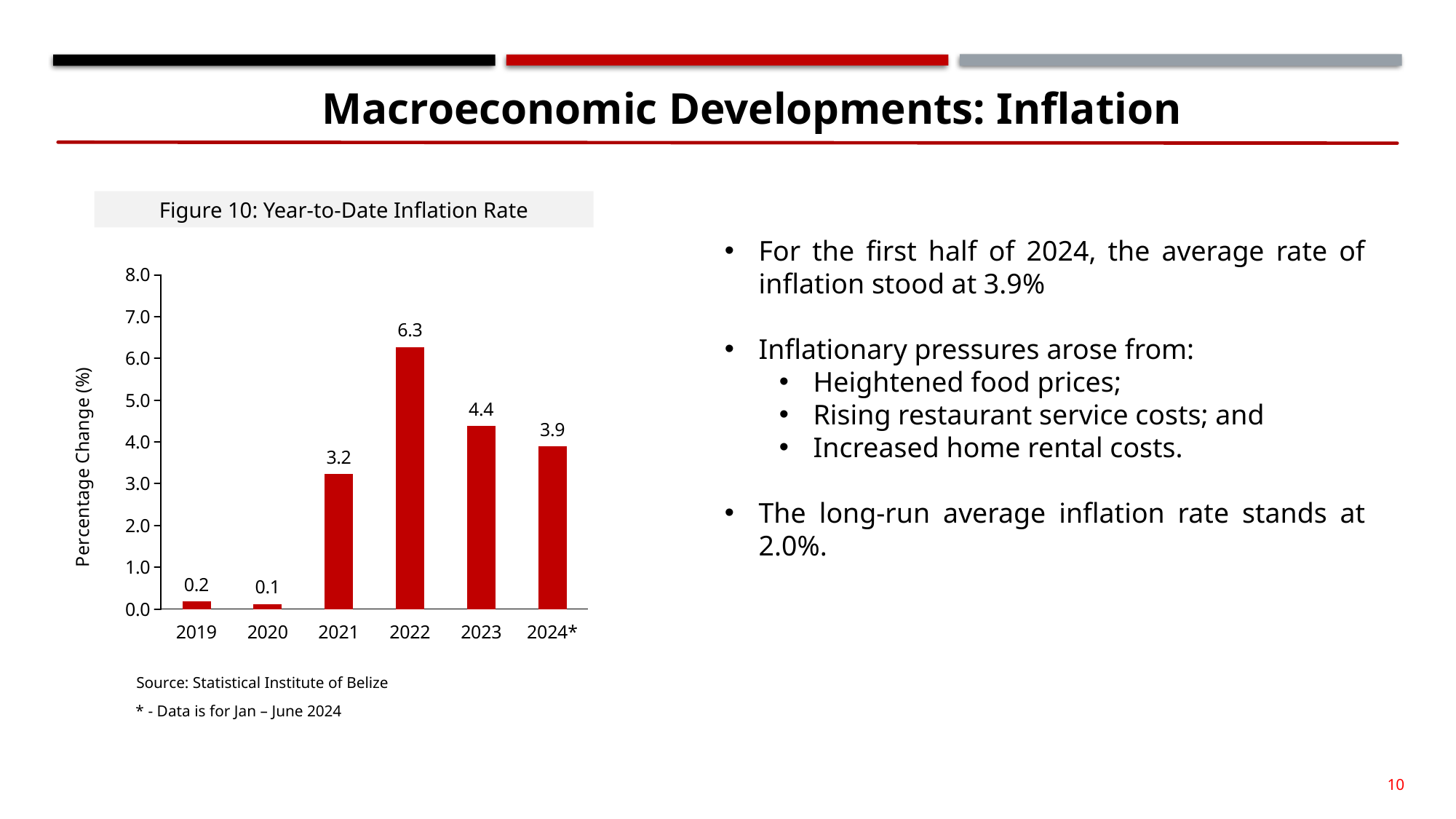
Is the value for 2022 greater or less than 6.0? greater What is the difference between the values for 2022 and 2023? 1.9 Which year has the lowest inflation rate in the chart? 2020 What is the title of the chart? Figure 10: Year-to-Date Inflation Rate How many years are shown on the x axis of the chart? 6 What is the value shown for 2020? 0.1 Which year has the highest inflation rate in the chart? 2022 What kind of chart is Figure 10? bar chart Do the values rise or fall from 2022 to 2024*? fall Which is larger, the value for 2021 or the value for 2023? 2023 What is the value shown for 2024*? 3.9 What is the year-to-date inflation rate shown for 2022? 6.3